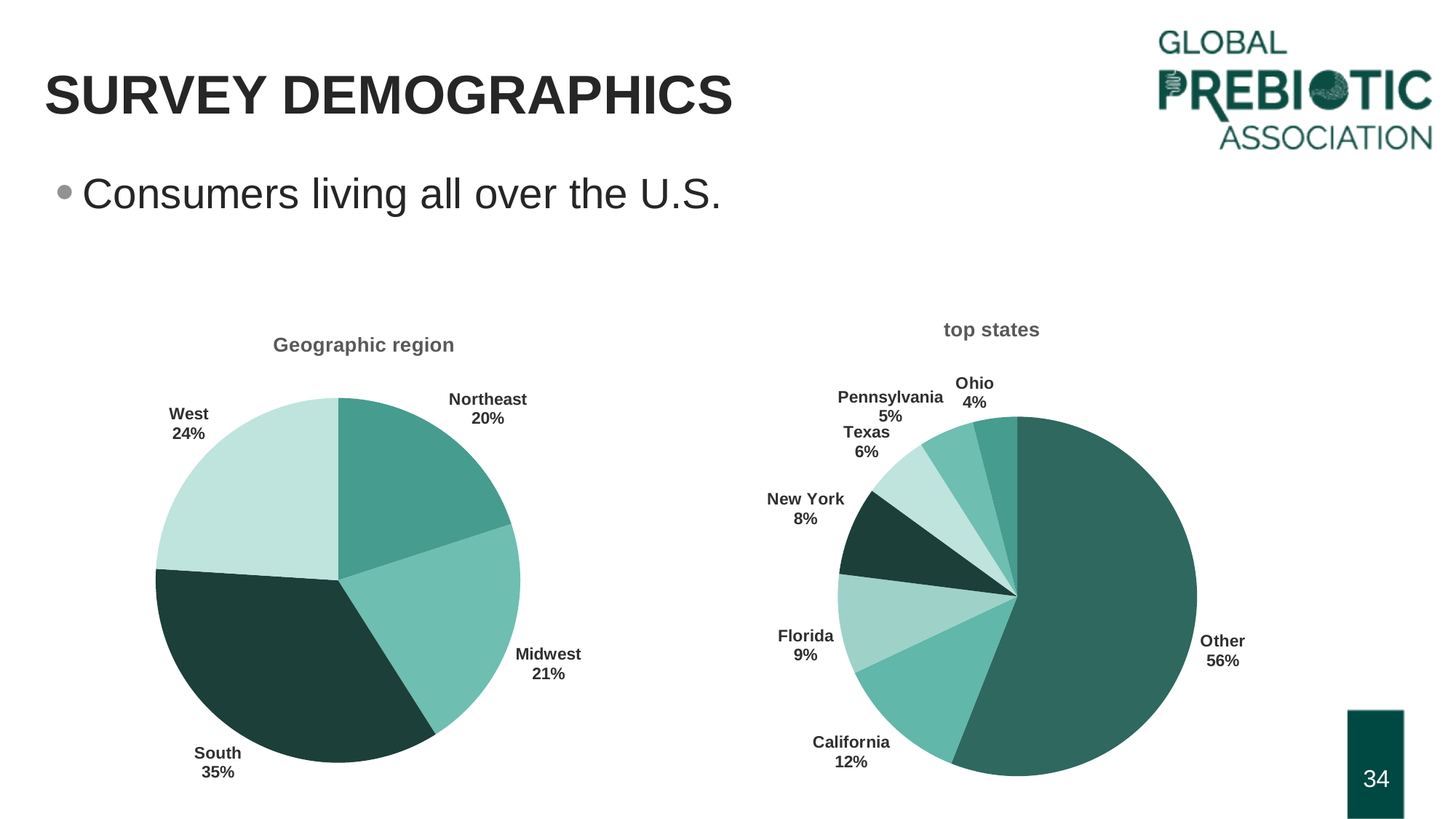
In the 'Geographic region' chart, how many regions are shown? 4 In the 'top states' chart, what share of consumers live in California? 12% In the 'Geographic region' chart, what share of consumers live in the South? 35% What type of chart is used for 'top states'? Pie chart In the 'top states' chart, which is larger, Florida or New York? Florida In the 'Geographic region' chart, what share of consumers live in the West? 24% In the 'Geographic region' chart, which region has the largest share? South In the 'Geographic region' chart, which region has the smallest share? Northeast In the 'top states' chart, which named state has the smallest share? Ohio In the 'top states' chart, what share of consumers live in Texas? 6% In the 'Geographic region' chart, what is the difference between the South and Midwest shares? 14% In the 'top states' chart, how many slices are there? 7